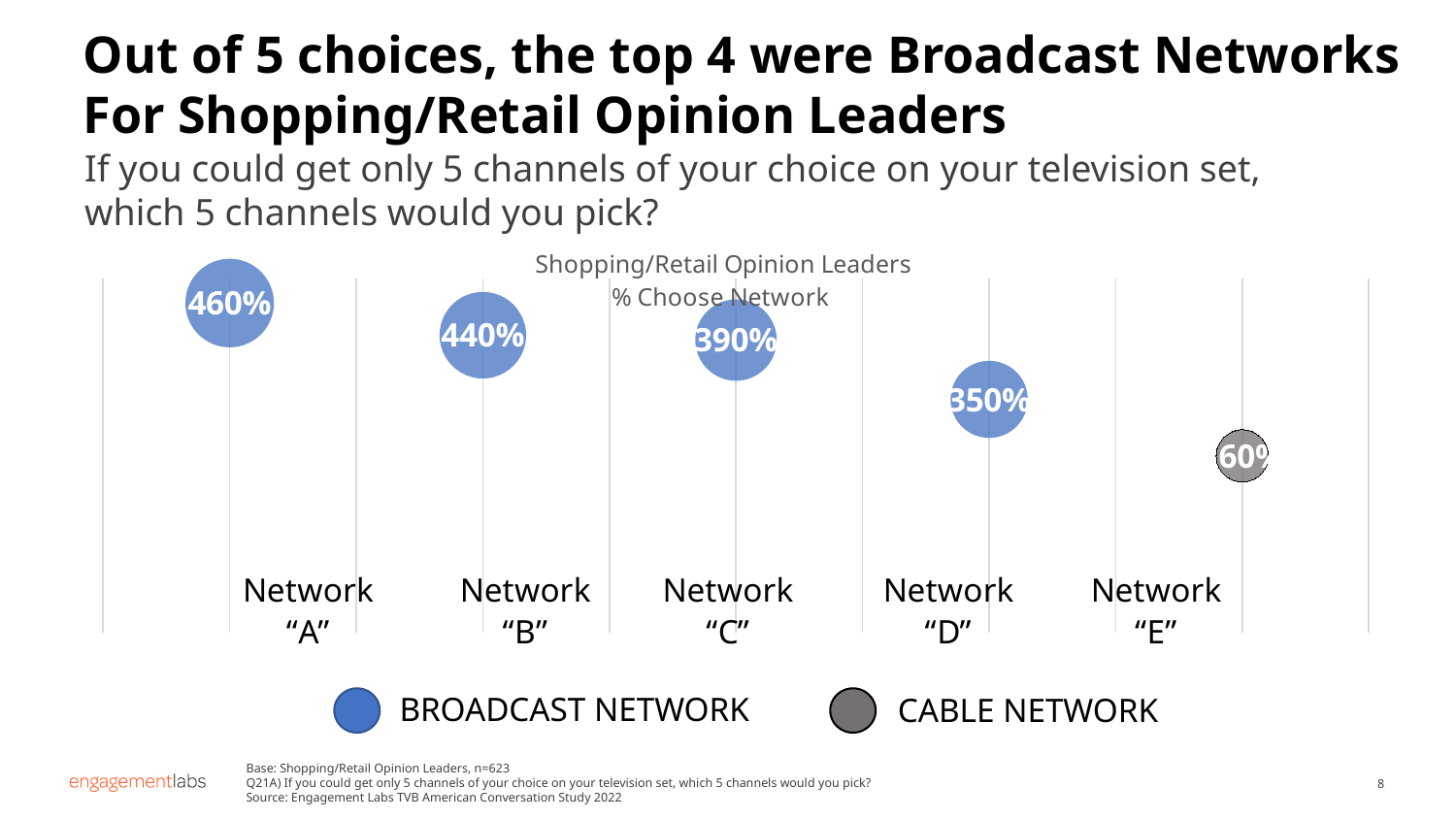
What is the value for Network "D"? 350% What is the value for Network "C"? 390% What is the value for Network "A"? 460% What is the difference between the values for Network "A" and Network "B"? 20% Which has a larger value, Network "B" or Network "D"? Network "B" How many entries does the legend list? 2 Which network has the highest value? Network "A" Do the values rise or fall from Network "A" to Network "E"? fall What is the difference between the values for Network "C" and Network "D"? 40% Which network has the lowest value? Network "E" How many networks are shown on the chart? 5 What is the value for Network "B"? 440%